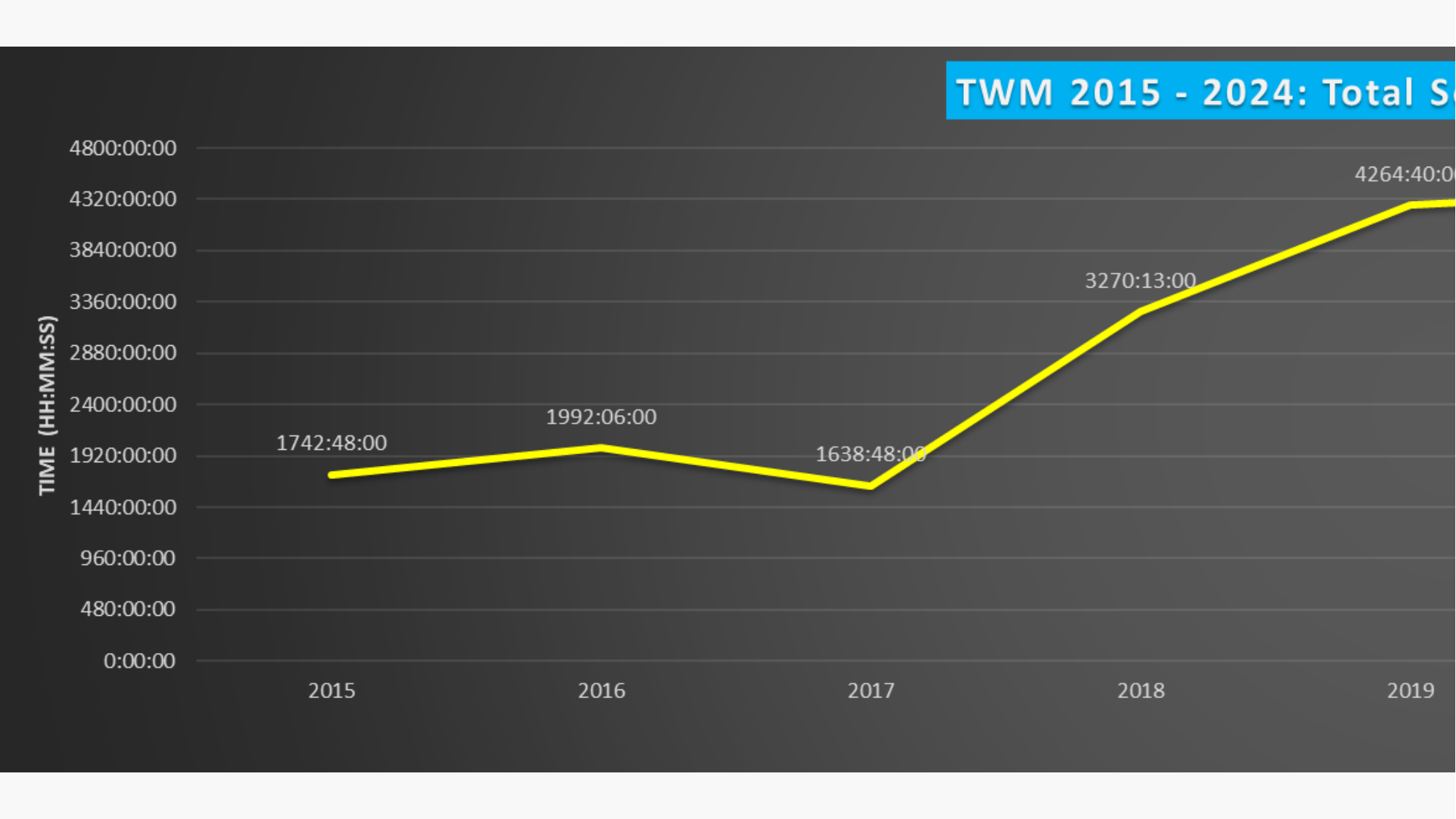
What is the difference between the values for 2016 and 2015? 249:18:00 What is the value for 2015? 1742:48:00 What is the value for 2017? 1638:48:00 Which is larger, the value for 2016 or the value for 2015? 2016 Which of the years shown has the lowest value? 2017 What is the value for 2016? 1992:06:00 What is the value for 2018? 3270:13:00 Do the values rise or fall from 2017 to 2019? rise Which of the years shown has the highest value? 2019 Is the value for 2018 greater or less than 2880:00:00? greater What is the label on the vertical axis? TIME (HH:MM:SS) What kind of chart is shown on the slide? line chart